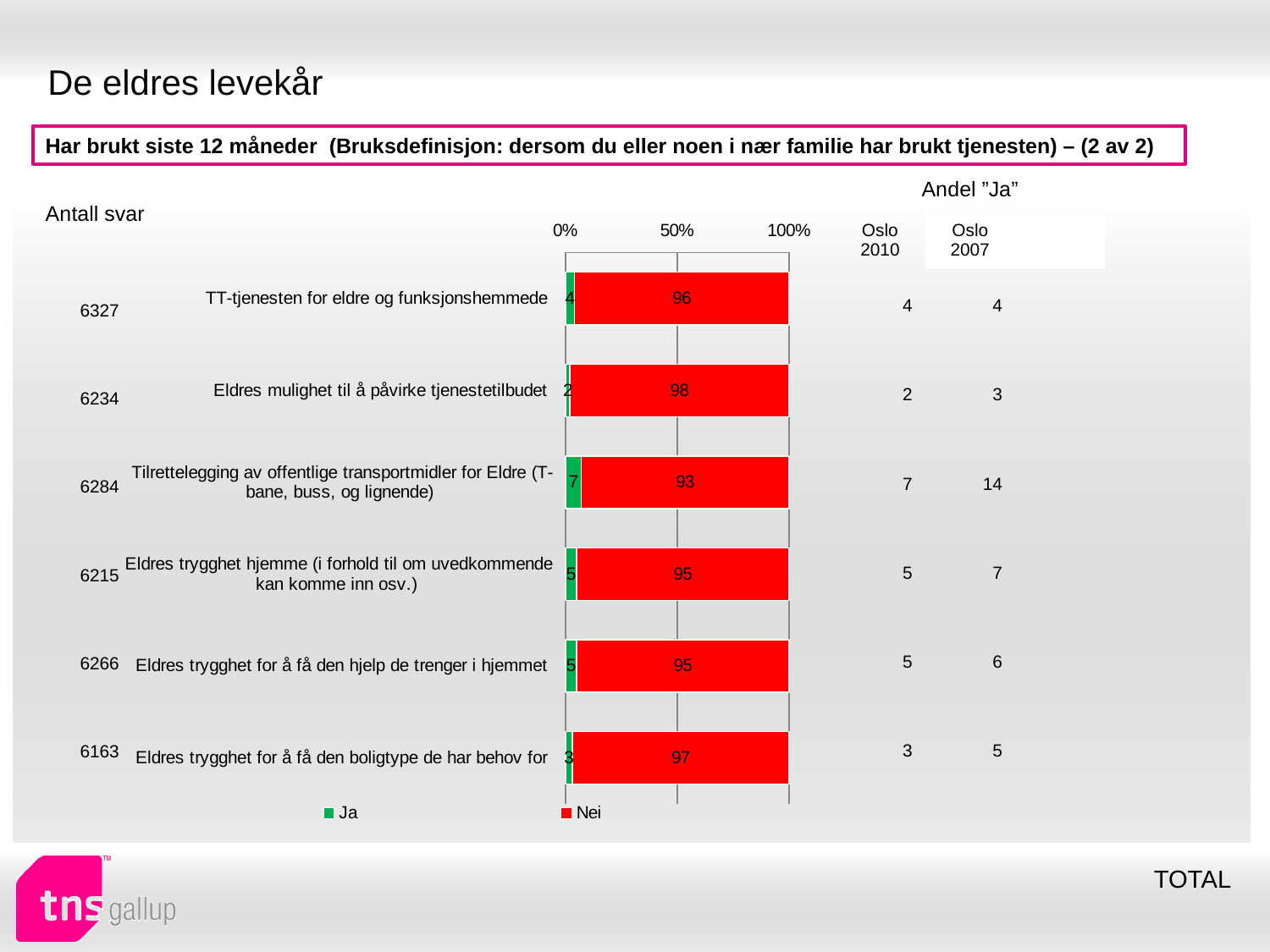
What kind of chart is shown on the slide? Stacked bar chart Which category has the lowest Nei value? Tilrettelegging av offentlige transportmidler for Eldre (T-bane, buss, og lignende) What is the value of the Nei series for "TT-tjenesten for eldre og funksjonshemmede"? 96 What is the difference between the Nei and Ja values for "TT-tjenesten for eldre og funksjonshemmede"? 92 Which category has the highest Nei value? Eldres mulighet til å påvirke tjenestetilbudet Which is larger: the Ja value for "Tilrettelegging av offentlige transportmidler for Eldre" or the Ja value for "Eldres mulighet til å påvirke tjenestetilbudet"? Tilrettelegging av offentlige transportmidler for Eldre What is the value of the Nei series for "Eldres trygghet for å få den boligtype de har behov for"? 97 Which category has the highest Ja value? Tilrettelegging av offentlige transportmidler for Eldre (T-bane, buss, og lignende) How many categories are shown in the chart? 6 What is the value of the Ja series for "Tilrettelegging av offentlige transportmidler for Eldre (T-bane, buss, og lignende)"? 7 How many series does the legend list? 2 What is the total of the stacked bar for "Eldres trygghet hjemme (i forhold til om uvedkommende kan komme inn osv.)"? 100